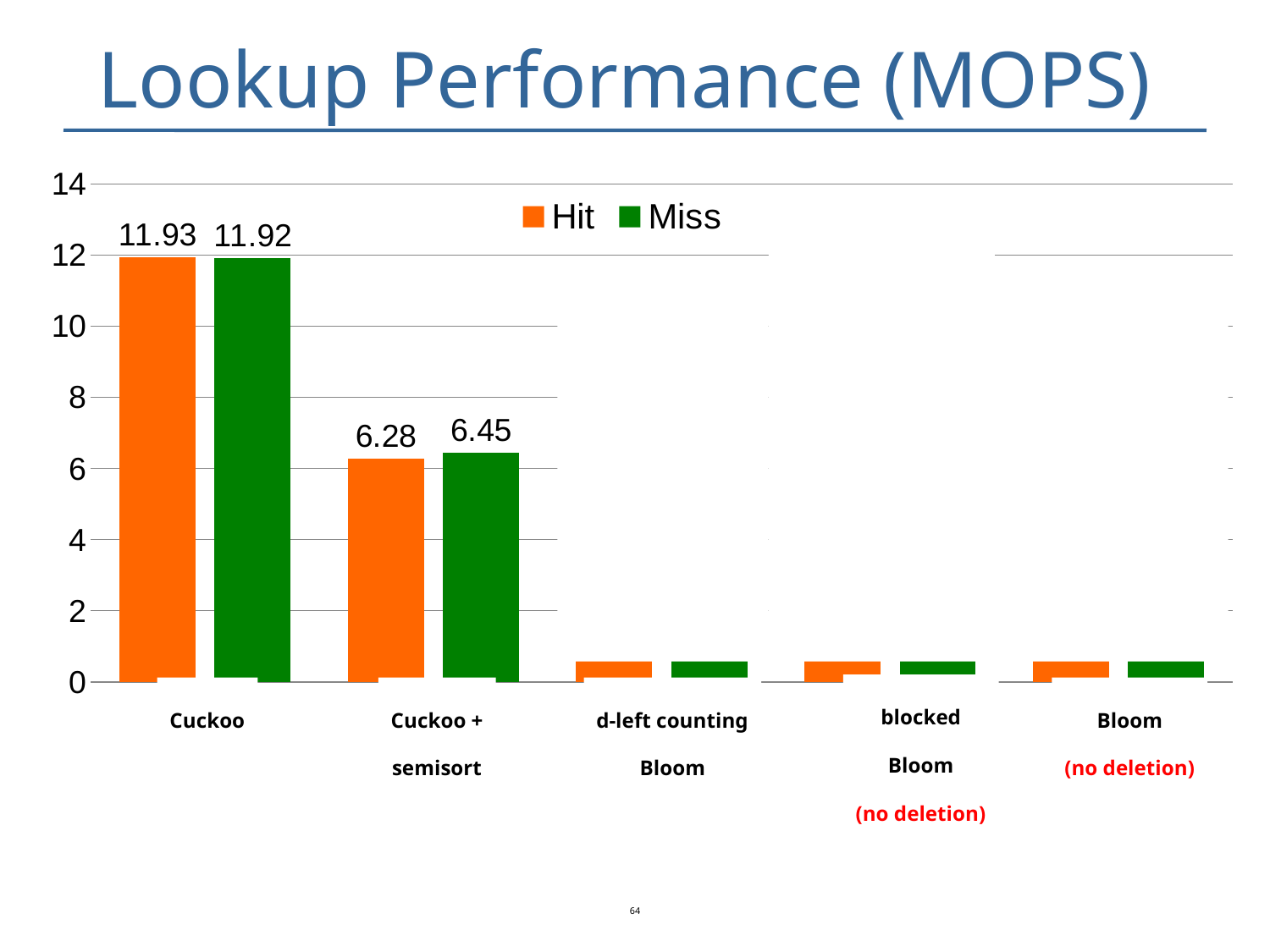
What is the Miss value for Cuckoo? 11.92 What is the Miss value for Cuckoo + semisort? 6.45 What is the difference between the Miss and Hit values for Cuckoo + semisort? 0.17 How many series does the legend list? 2 What is the difference between the Hit value for Cuckoo and the Hit value for Cuckoo + semisort? 5.65 For Cuckoo + semisort, which is larger, the Hit value or the Miss value? Miss Which category has the highest Hit value? Cuckoo Is the Hit value for d-left counting Bloom greater or less than 2? less What is the Hit value for Cuckoo? 11.93 What is the Hit value for Cuckoo + semisort? 6.28 How many categories are shown on the x axis? 5 What kind of chart is shown on the slide? bar chart